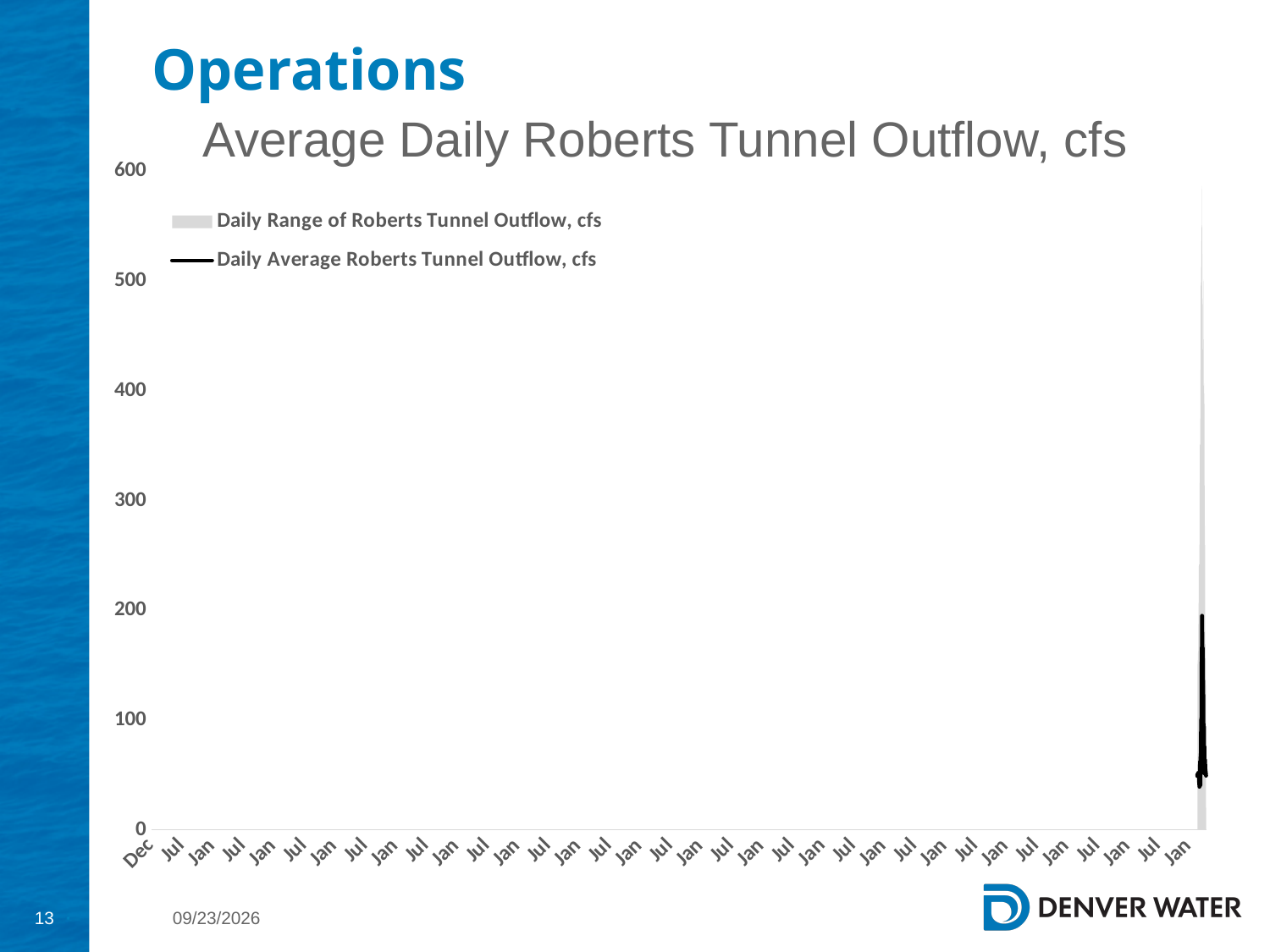
How many series does the chart legend list? 2 What is the title of the chart? Average Daily Roberts Tunnel Outflow, cfs What is the last label on the chart's horizontal axis? Jan Is the peak of the Daily Average Roberts Tunnel Outflow line greater or less than 300? less What kind of chart is shown on the slide? combination area and line chart What is the name of the series drawn as a black line in the chart? Daily Average Roberts Tunnel Outflow, cfs What is the first label on the chart's horizontal axis? Dec What is the lowest value shown on the chart's vertical axis? 0 What is the interval between consecutive tick values on the chart's vertical axis? 100 What is the highest value shown on the chart's vertical axis? 600